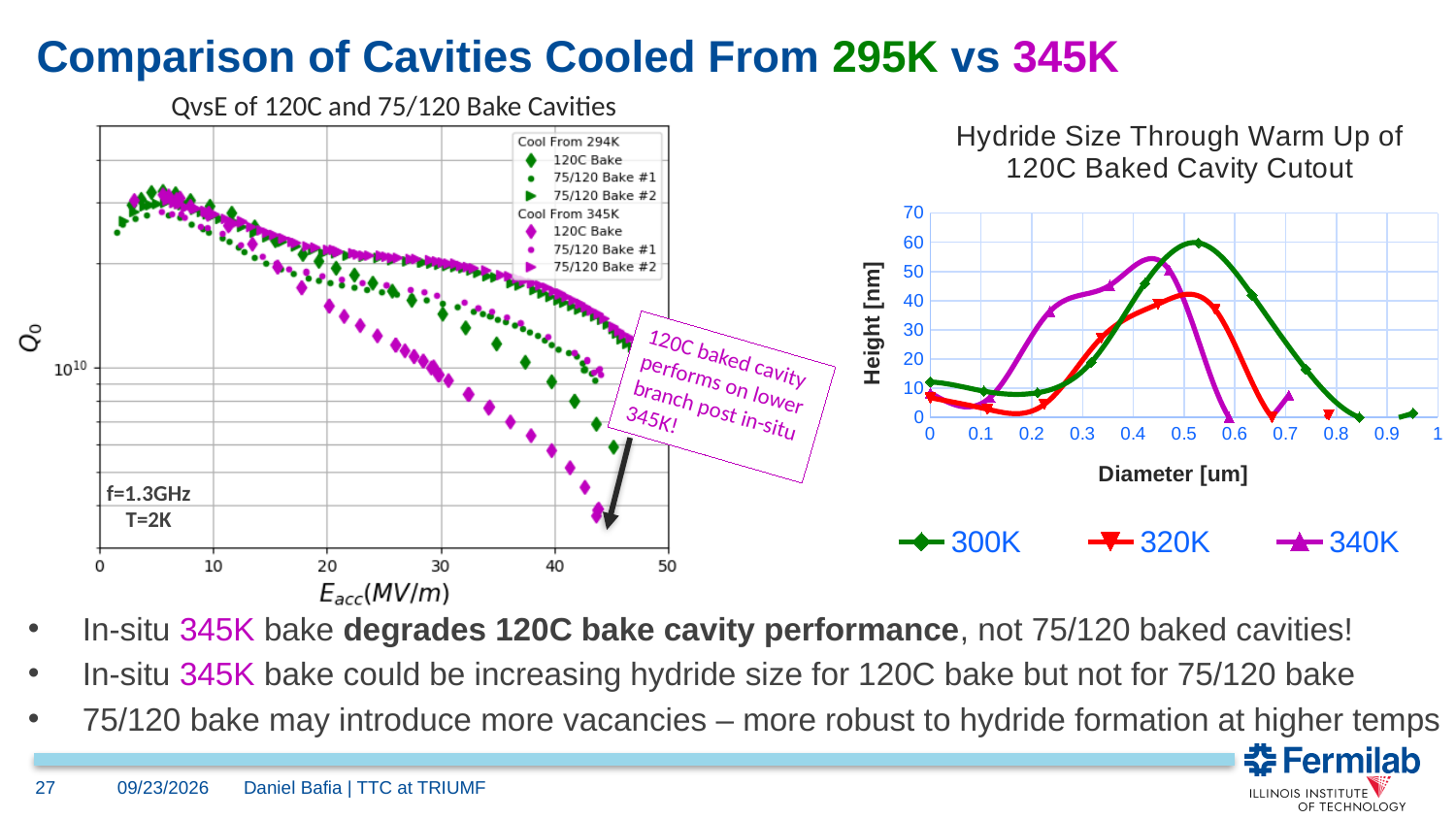
What is the x-axis label of the 'Hydride Size Through Warm Up of 120C Baked Cavity Cutout' chart? Diameter [um] How many series does the legend of the 'Hydride Size Through Warm Up of 120C Baked Cavity Cutout' chart list? 3 What kind of chart is the 'Hydride Size Through Warm Up of 120C Baked Cavity Cutout' chart? line chart In the 'Hydride Size Through Warm Up of 120C Baked Cavity Cutout' chart, does the 300K series rise or fall between diameters of 0.2 um and 0.5 um? rise In the 'Hydride Size Through Warm Up of 120C Baked Cavity Cutout' chart, which series reaches the lowest peak height? 320K In the 'Hydride Size Through Warm Up of 120C Baked Cavity Cutout' chart, is the peak height of the 300K series greater or less than 50 nm? greater In the 'Hydride Size Through Warm Up of 120C Baked Cavity Cutout' chart, which series peaks at a smaller diameter, 340K or 300K? 340K In the 'QvsE of 120C and 75/120 Bake Cavities' chart, what frequency and temperature are annotated on the plot? f=1.3GHz, T=2K In the 'Hydride Size Through Warm Up of 120C Baked Cavity Cutout' chart, is the 340K series value at a diameter of 0.6 um greater or less than 10 nm? less How many series does the legend of the 'QvsE of 120C and 75/120 Bake Cavities' chart list? 6 What is the y-axis label of the 'Hydride Size Through Warm Up of 120C Baked Cavity Cutout' chart? Height [nm] In the 'Hydride Size Through Warm Up of 120C Baked Cavity Cutout' chart, is the peak height of the 320K series greater or less than 50 nm? less